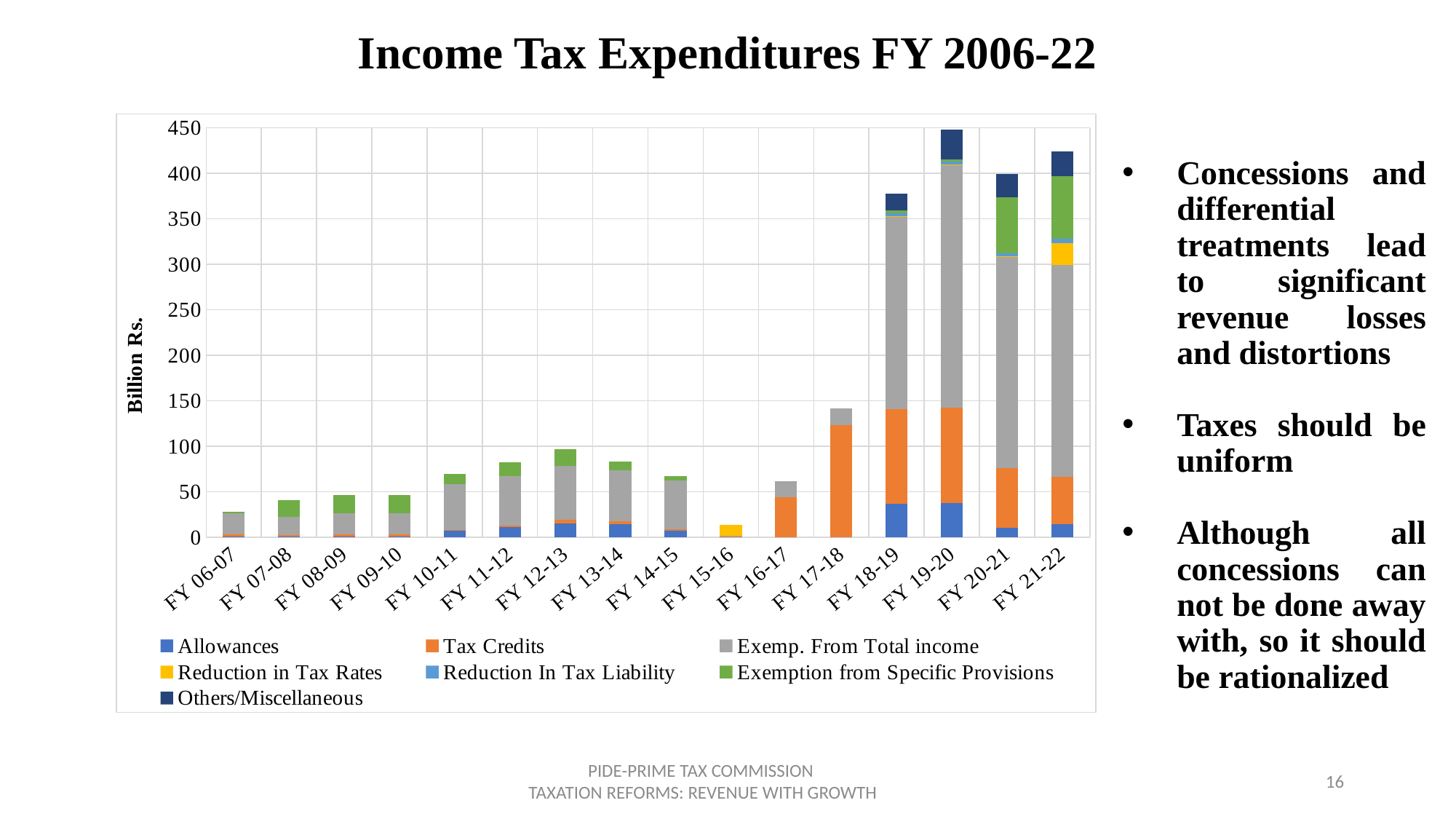
How many series does the chart's legend list? 7 Is the total value for FY 06-07 greater or less than 50? less Is the total value for FY 18-19 greater or less than 350? greater What unit is shown on the y axis of the chart? Billion Rs. What kind of chart is shown on the slide? Stacked bar chart Is the total value for FY 19-20 greater or less than 400? greater Do the total values rise or fall from FY 16-17 to FY 19-20? rise Which fiscal year has the lowest total income tax expenditure? FY 15-16 Which fiscal year has the highest total income tax expenditure? FY 19-20 Which has the larger total, FY 18-19 or FY 17-18? FY 18-19 How many fiscal years are shown on the x axis of the chart? 16